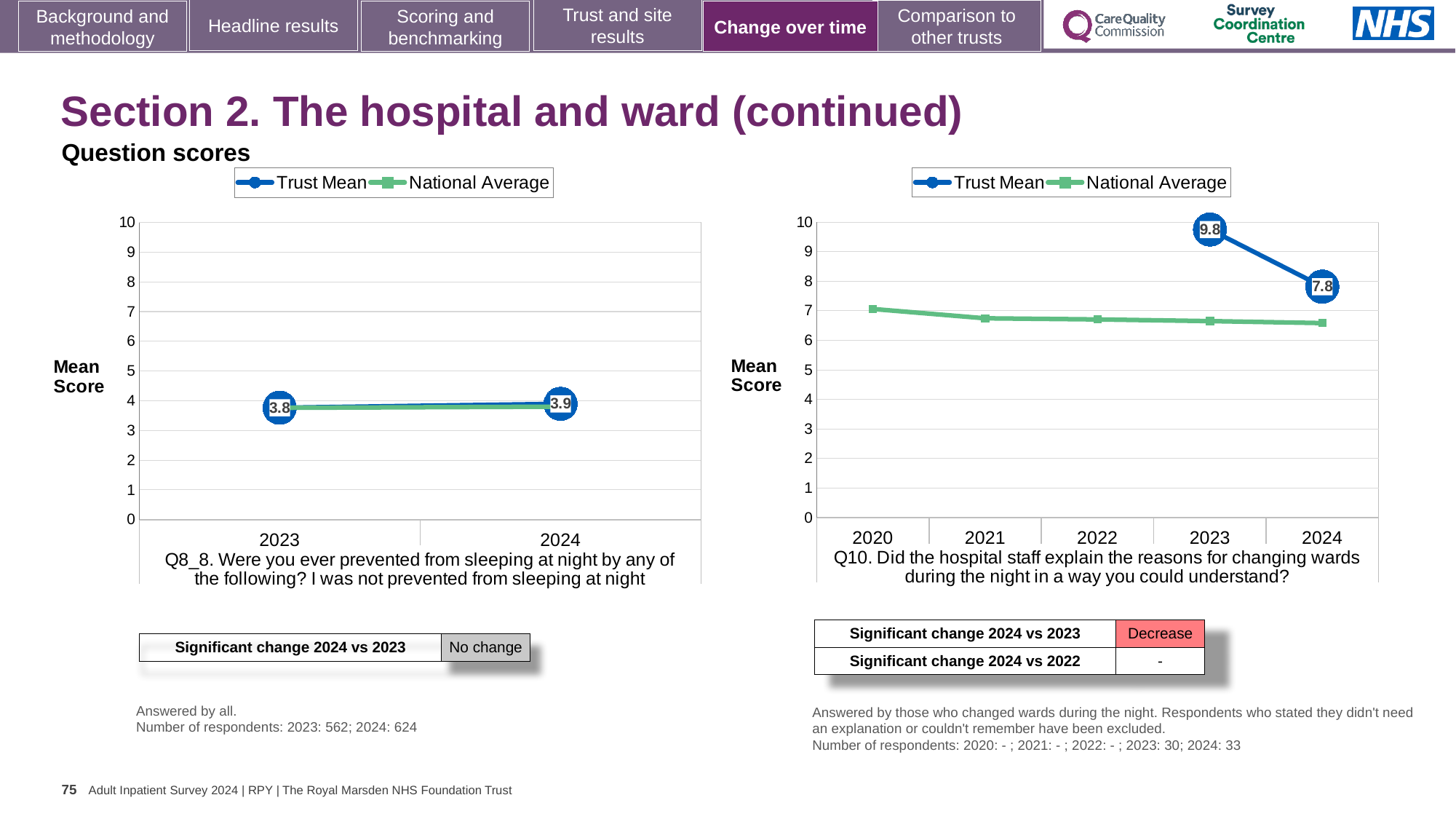
In the Q10 chart on the right, by how much did the Trust Mean fall from 2023 to 2024? 2.0 In the Q8_8 chart on the left, what is the Trust Mean score for 2024? 3.9 What type of chart is used for the Q8_8 question on the left? line chart In the Q10 chart on the right, is the Trust Mean for 2023 higher or lower than the National Average for 2023? higher In the Q10 chart on the right, what is the Trust Mean score for 2024? 7.8 How many series does the legend of the Q8_8 chart on the left list? 2 How many years are shown on the x axis of the Q10 chart on the right? 5 What does the significant change 2024 vs 2023 table below the Q10 chart say? Decrease In the Q10 chart on the right, does the Trust Mean rise or fall from 2023 to 2024? fall In the Q10 chart on the right, is the National Average for 2024 greater or less than 7? less In the Q8_8 chart on the left, what is the Trust Mean score for 2023? 3.8 In the Q10 chart on the right, what is the Trust Mean score for 2023? 9.8